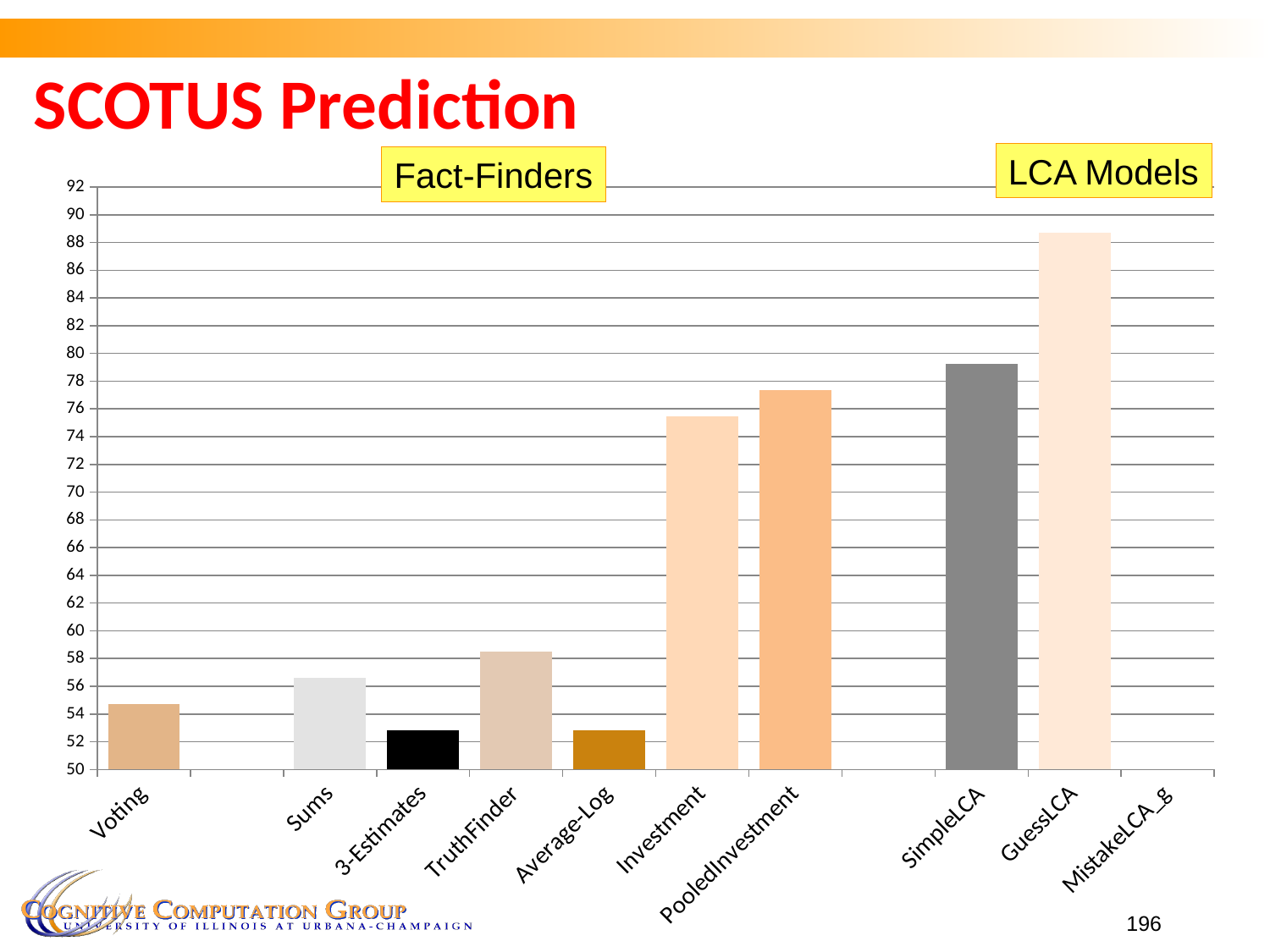
How many category labels are shown on the x axis of the chart? 10 What kind of chart is shown on the slide? bar chart Which has the larger value, Sums or Voting? Sums Is the value for GuessLCA greater or less than 88? greater What are the two group labels shown in yellow boxes above the chart? Fact-Finders and LCA Models Is the value for SimpleLCA greater or less than 80? less What is the title of the slide containing the chart? SCOTUS Prediction Is the value for Investment greater or less than 74? greater Which has the larger value, Investment or PooledInvestment? PooledInvestment Which category has the highest bar in the chart? GuessLCA